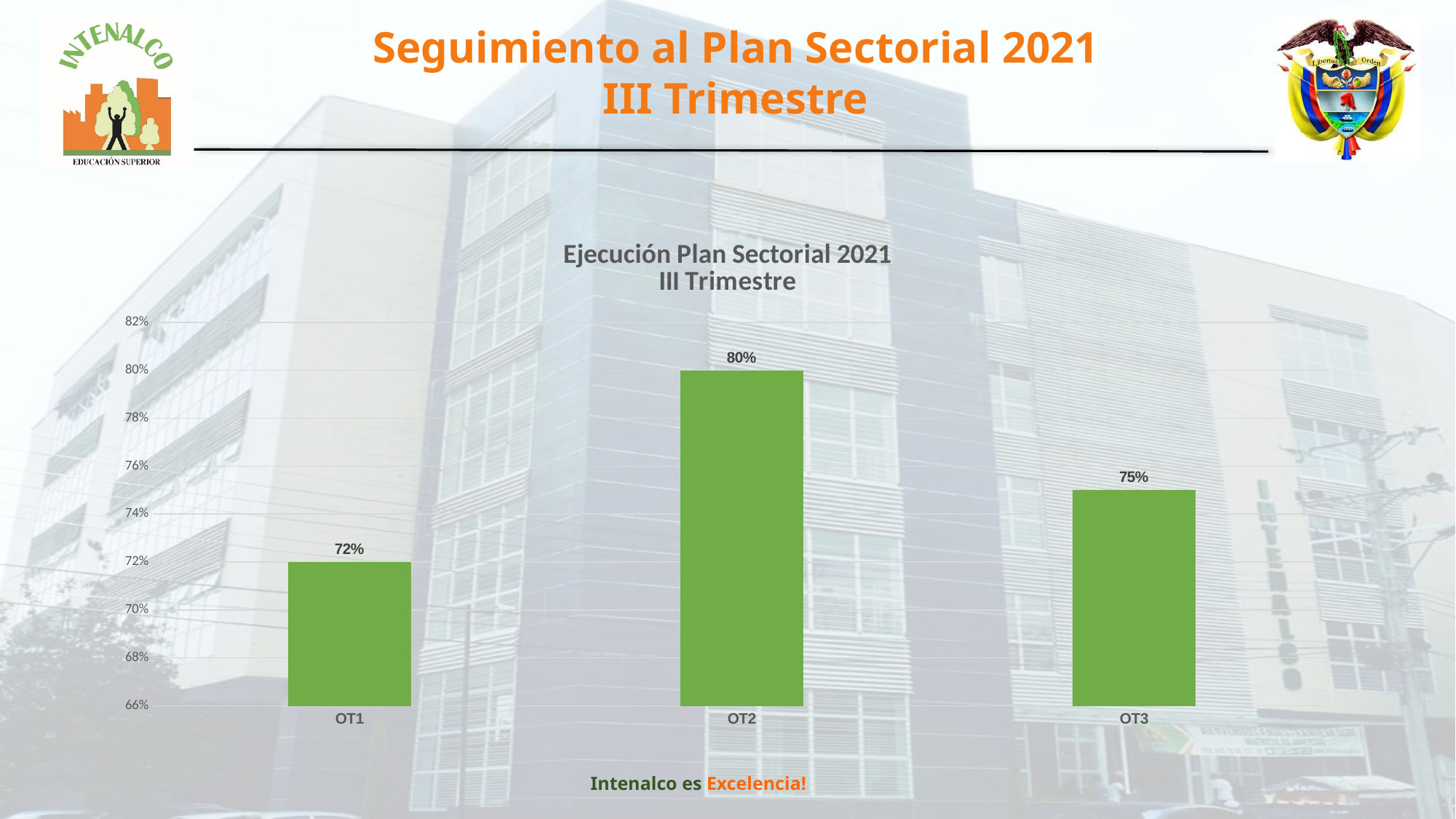
Is the value for OT3 greater or less than 74%? greater Which category has the highest value? OT2 How many categories are shown in the chart? 3 Which is larger, the value for OT3 or the value for OT1? OT3 What is the value for OT2? 80% What is the difference between the values for OT2 and OT1? 8% Which category has the lowest value? OT1 What kind of chart is shown on the slide? bar chart What is the title of the chart? Ejecución Plan Sectorial 2021 III Trimestre What is the difference between the values for OT2 and OT3? 5% What is the value for OT1? 72% What is the value for OT3? 75%